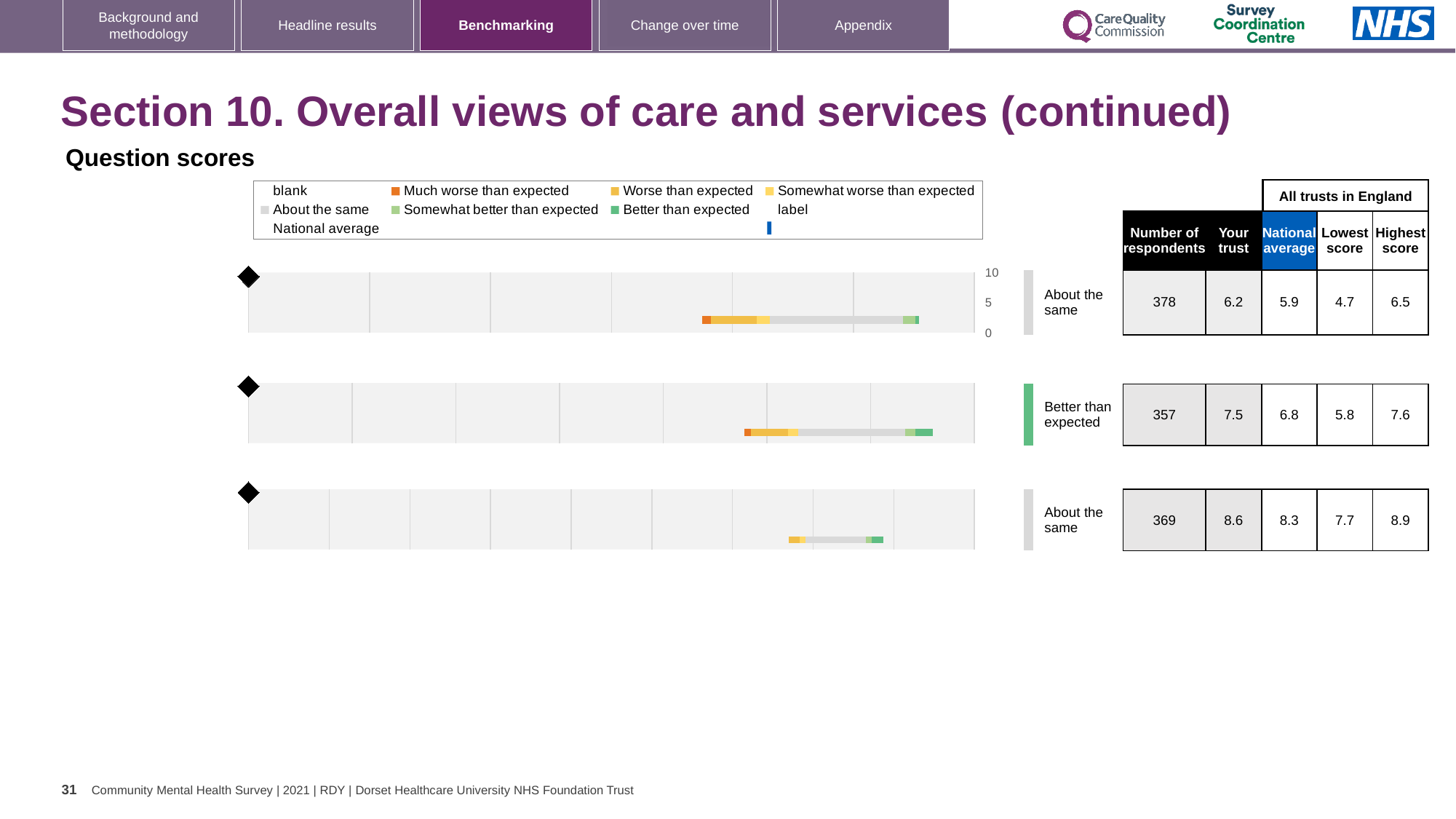
Which of the three charts has the highest 'Your trust' score? the bottom chart (8.6) Which of the three charts has the lowest number of respondents? the middle chart (357) How many question score charts are shown on the slide? 3 Which of the three charts is rated 'Better than expected'? the middle chart For the top chart, what is the difference between the 'Your trust' score and the national average? 0.3 For the bottom chart, what is the difference between the highest score and the lowest score among all trusts in England? 1.2 For the middle chart, which is larger: the 'Your trust' score or the national average? Your trust For the top chart (378 respondents), what is the 'Your trust' score? 6.2 For the middle chart (357 respondents), what is the national average score? 6.8 For the middle chart, how many respondents are there? 357 For the bottom chart (369 respondents), what is the highest score among all trusts in England? 8.9 What kind of chart is used to show the question scores on this slide? bar chart